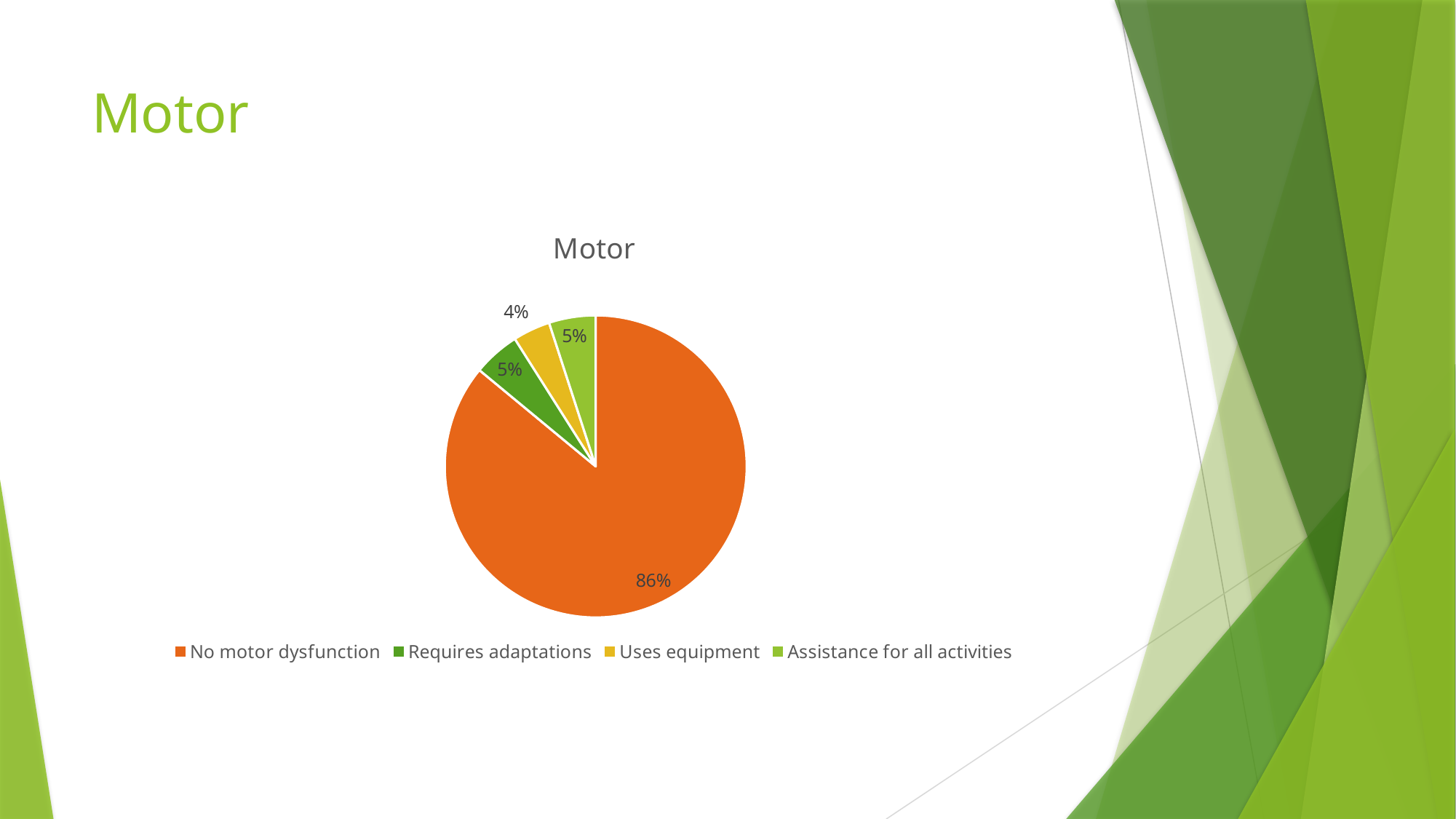
What share of the pie does "Uses equipment" represent? 4% What colour is the slice for "Uses equipment"? yellow Which category has the largest slice of the pie? No motor dysfunction What is the difference between the shares for "Requires adaptations" and "Uses equipment"? 1% Which category has the smallest slice of the pie? Uses equipment What share of the pie does "Requires adaptations" represent? 5% Which is larger, the share for "No motor dysfunction" or the share for "Assistance for all activities"? No motor dysfunction What is the chart type of the chart titled "Motor"? pie chart How many categories does the pie chart show? 4 What share of the pie does "Assistance for all activities" represent? 5% What is the difference between the shares for "No motor dysfunction" and "Requires adaptations"? 81%